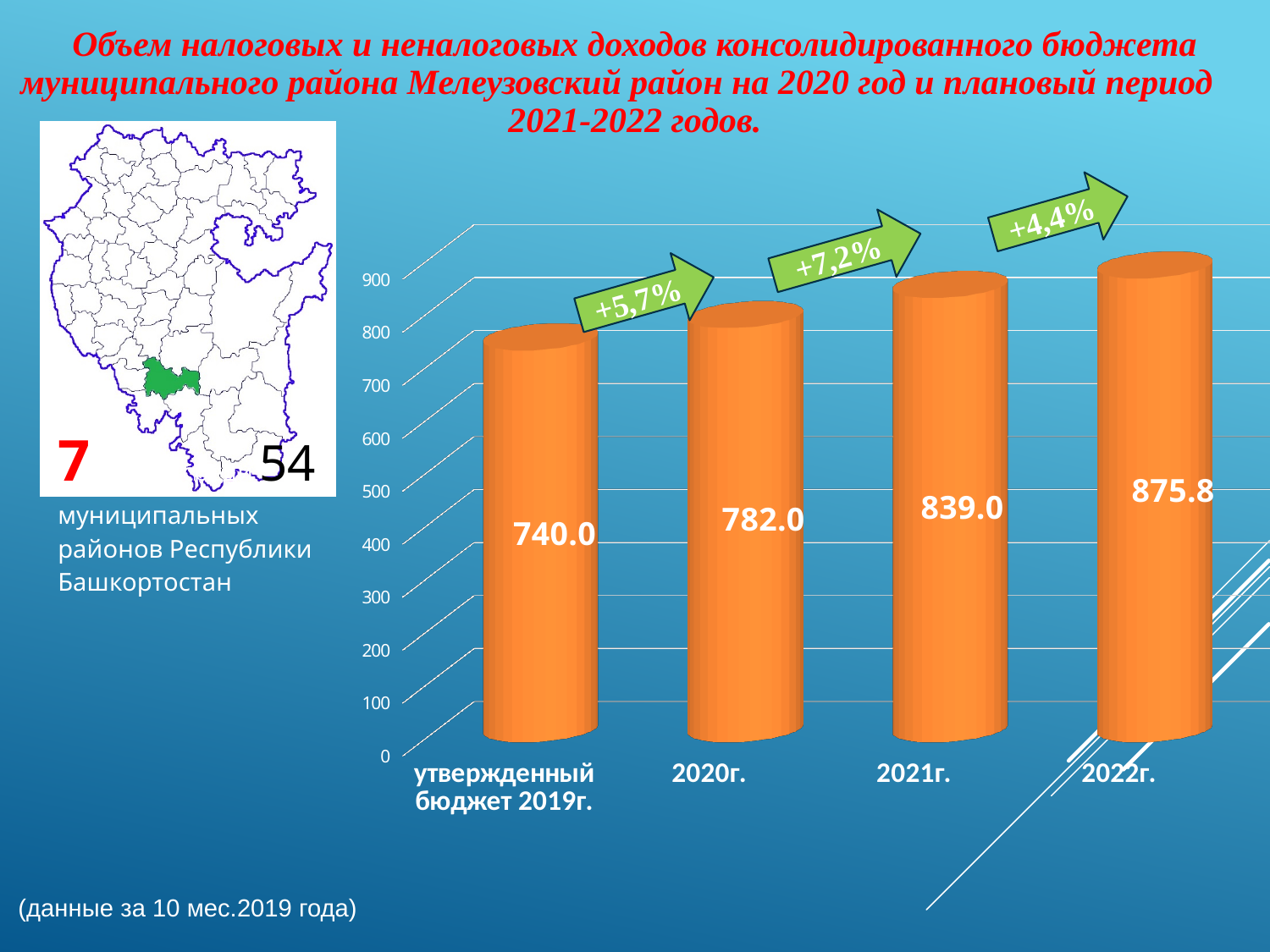
How many categories are shown on the x axis? 4 Is the value for 2022г. greater or less than 800? greater What kind of chart is shown on the slide? bar chart What is the value for 2020г.? 782.0 What is the difference between the values for 2022г. and утвержденный бюджет 2019г.? 135.8 Which is larger, the value for 2021г. or the value for 2020г.? 2021г. Do the values rise or fall from left to right along the x axis? rise What is the value for 2022г.? 875.8 What is the value for утвержденный бюджет 2019г.? 740.0 Which category has the lowest value? утвержденный бюджет 2019г. Which category has the highest value? 2022г. What is the difference between the values for 2021г. and 2020г.? 57.0